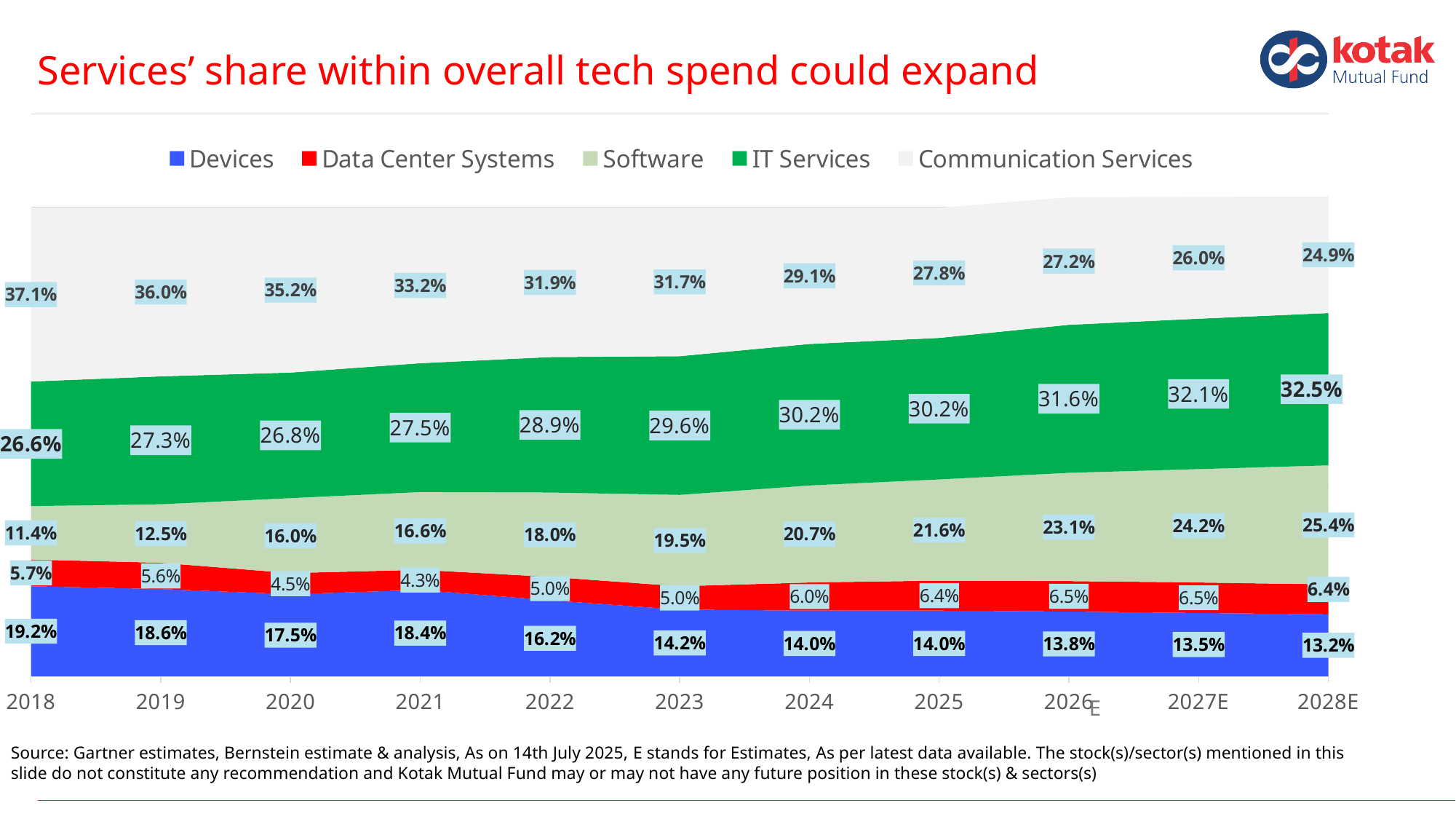
How many series does the legend list? 5 What is the title of the slide? Services' share within overall tech spend could expand Does the Communication Services share rise or fall from 2018 to 2028E? Fall What kind of chart is shown on the slide? Stacked area chart What is the value for IT Services in 2028E? 32.5% In which year is the Devices share lowest? 2028E What is the value for Software in 2018? 11.4% By how many percentage points does the Software share in 2028E exceed its share in 2018? 14.0 percentage points How many years are shown on the x axis? 11 What is the value for Devices in 2023? 14.2% In 2025, which is larger: the IT Services share or the Communication Services share? IT Services In which year is the Communication Services share highest? 2018